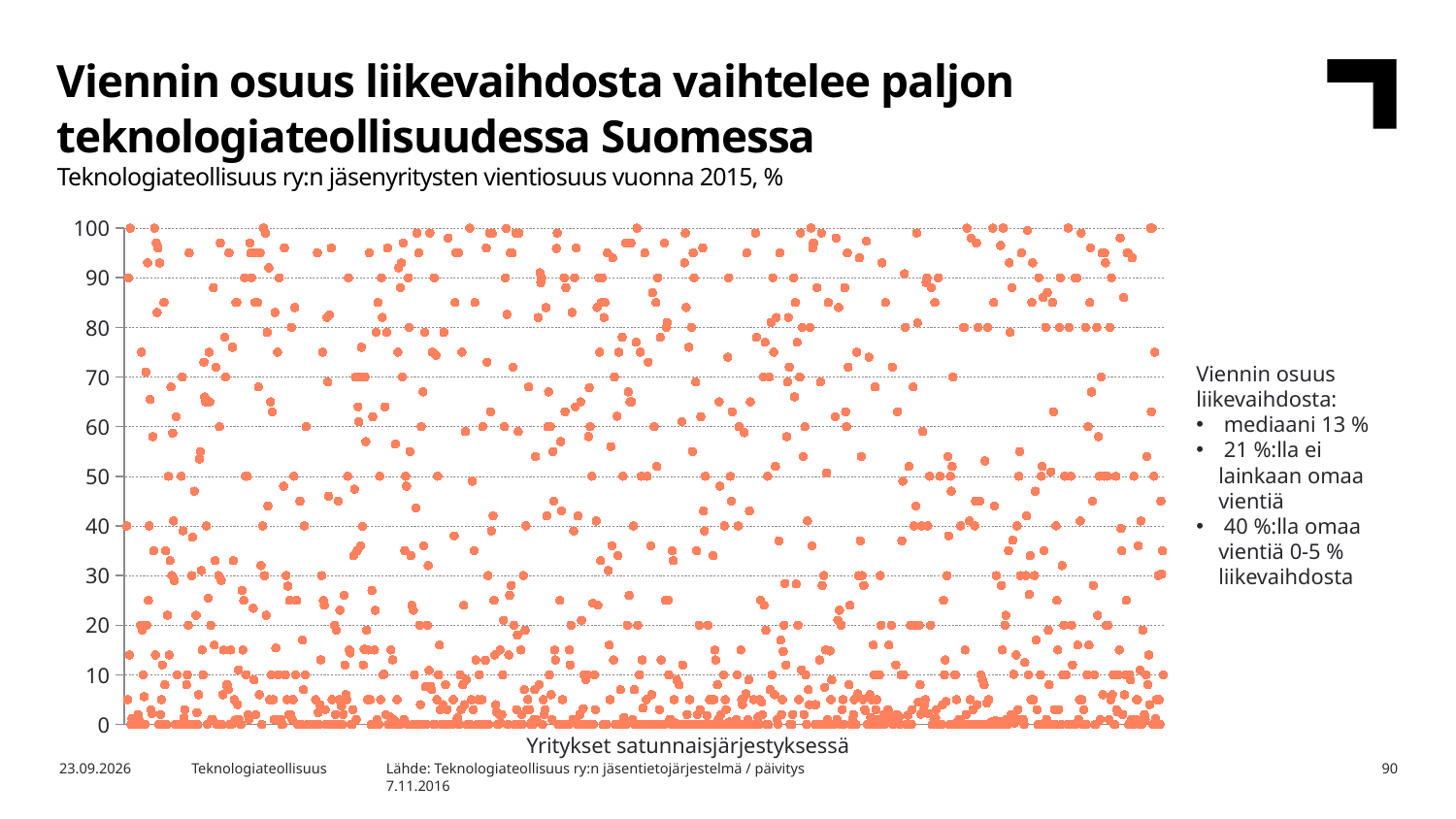
According to the annotation next to the chart, what is the median export share of turnover? 13 % What kind of chart is shown on the slide? Scatter chart What is the lowest export share value plotted in the chart? 0 What is the difference between the share of companies with exports of 0-5 % of turnover and the share with no exports at all? 19 % What is the highest export share value plotted in the chart? 100 According to the annotation next to the chart, what share of companies have no exports at all? 21 % What is the label of the x axis of the chart? Yritykset satunnaisjärjestyksessä According to the annotation next to the chart, what share of companies have exports of 0-5 % of turnover? 40 % Is the share of companies with exports of 0-5 % of turnover larger or smaller than the share with no exports at all? Larger What is the title of the chart on the slide? Viennin osuus liikevaihdosta vaihtelee paljon teknologiateollisuudessa Suomessa